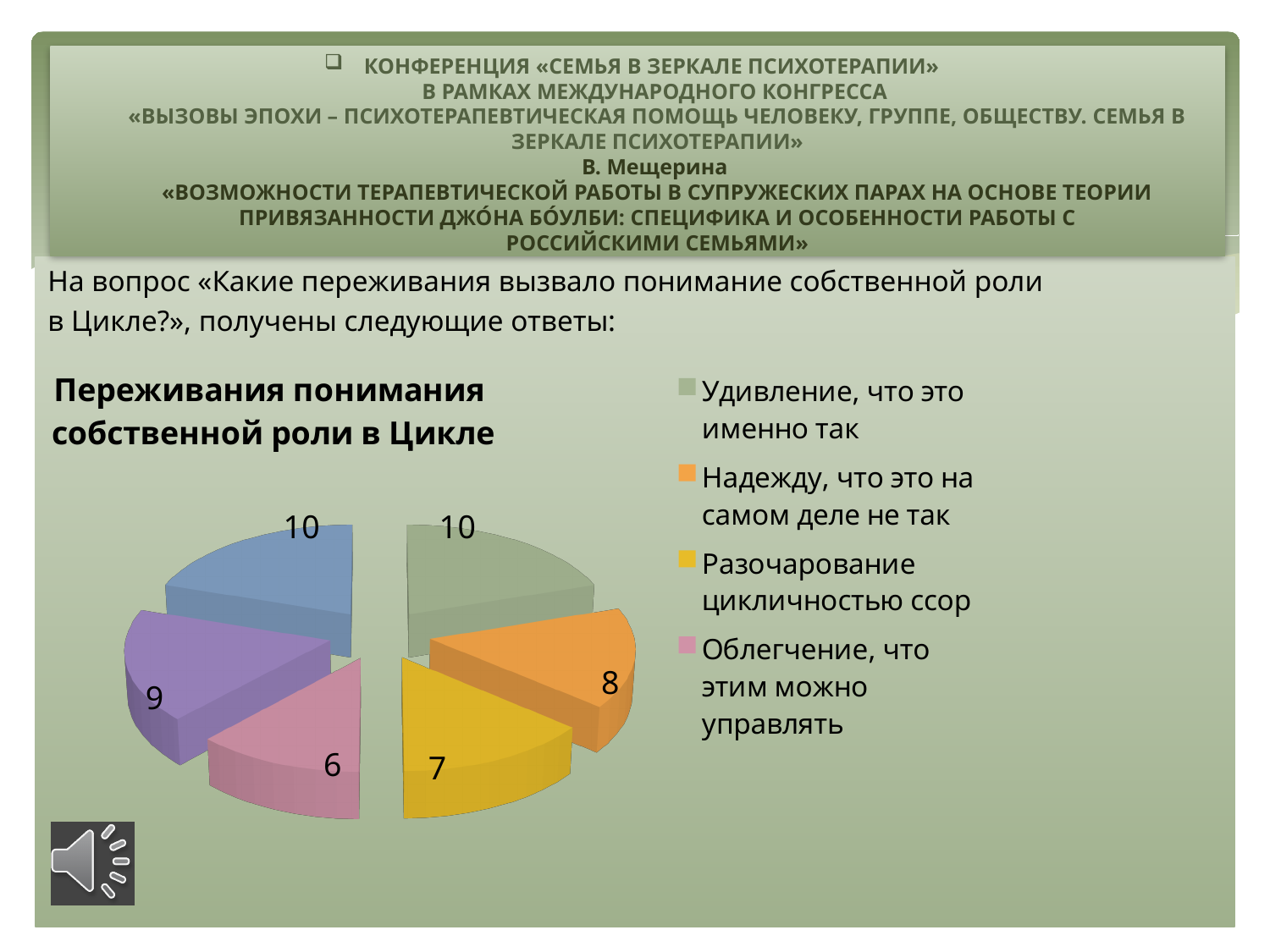
What is the difference between the values for «Удивление, что это именно так» and «Облегчение, что этим можно управлять»? 4 What is the value for «Разочарование цикличностью ссор»? 7 What is the title of the pie chart? Переживания понимания собственной роли в Цикле What is the value for «Удивление, что это именно так»? 10 What kind of chart is shown on the slide? pie chart How many slices does the pie chart have? 6 What share of the pie does «Удивление, что это именно так» represent? 20% Which is larger: «Надежду, что это на самом деле не так» or «Разочарование цикличностью ссор»? Надежду, что это на самом деле не так What is the value for «Надежду, что это на самом деле не так»? 8 What is the value for «Облегчение, что этим можно управлять»? 6 Which category has the smallest slice in the pie chart? Облегчение, что этим можно управлять How many entries does the legend list? 4